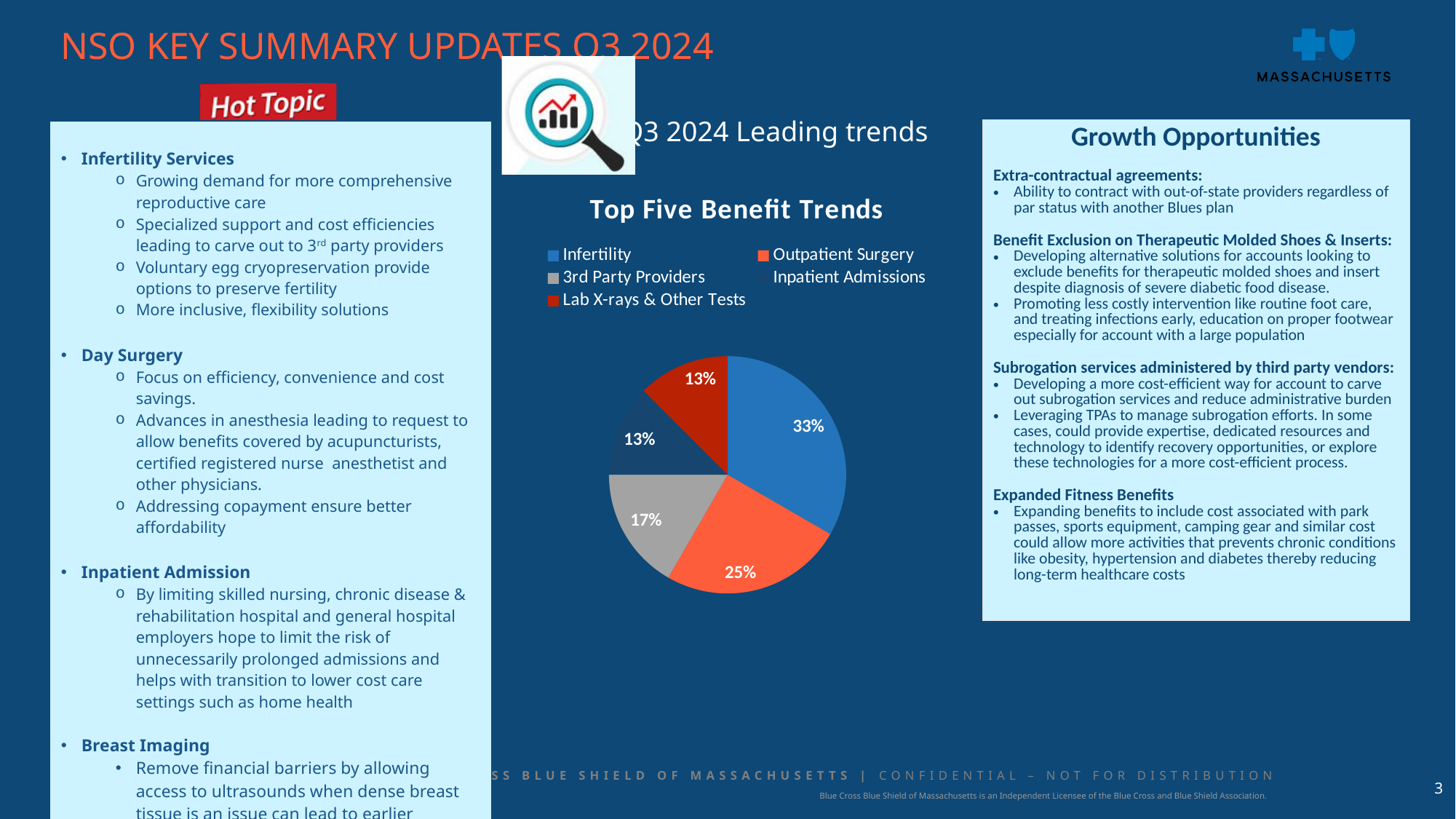
In the Top Five Benefit Trends pie chart, what is the difference in percentage points between Infertility and Outpatient Surgery? 8 percentage points What is the title of the pie chart on the slide? Top Five Benefit Trends How many slices does the Top Five Benefit Trends pie chart have? 5 What share of the Top Five Benefit Trends pie does Inpatient Admissions represent? 13% In the Top Five Benefit Trends pie chart, what percentage is shown for Lab X-rays & Other Tests? 13% In the Top Five Benefit Trends pie chart, what percentage is shown for Outpatient Surgery? 25% In the Top Five Benefit Trends pie chart, what percentage is shown for Infertility? 33% What type of chart is shown under the title "Top Five Benefit Trends"? Pie chart In the Top Five Benefit Trends pie chart, which is larger: 3rd Party Providers or Outpatient Surgery? Outpatient Surgery How many entries does the legend of the Top Five Benefit Trends chart list? 5 In the Top Five Benefit Trends pie chart, what percentage is shown for 3rd Party Providers? 17% Which category has the largest slice in the Top Five Benefit Trends pie chart? Infertility